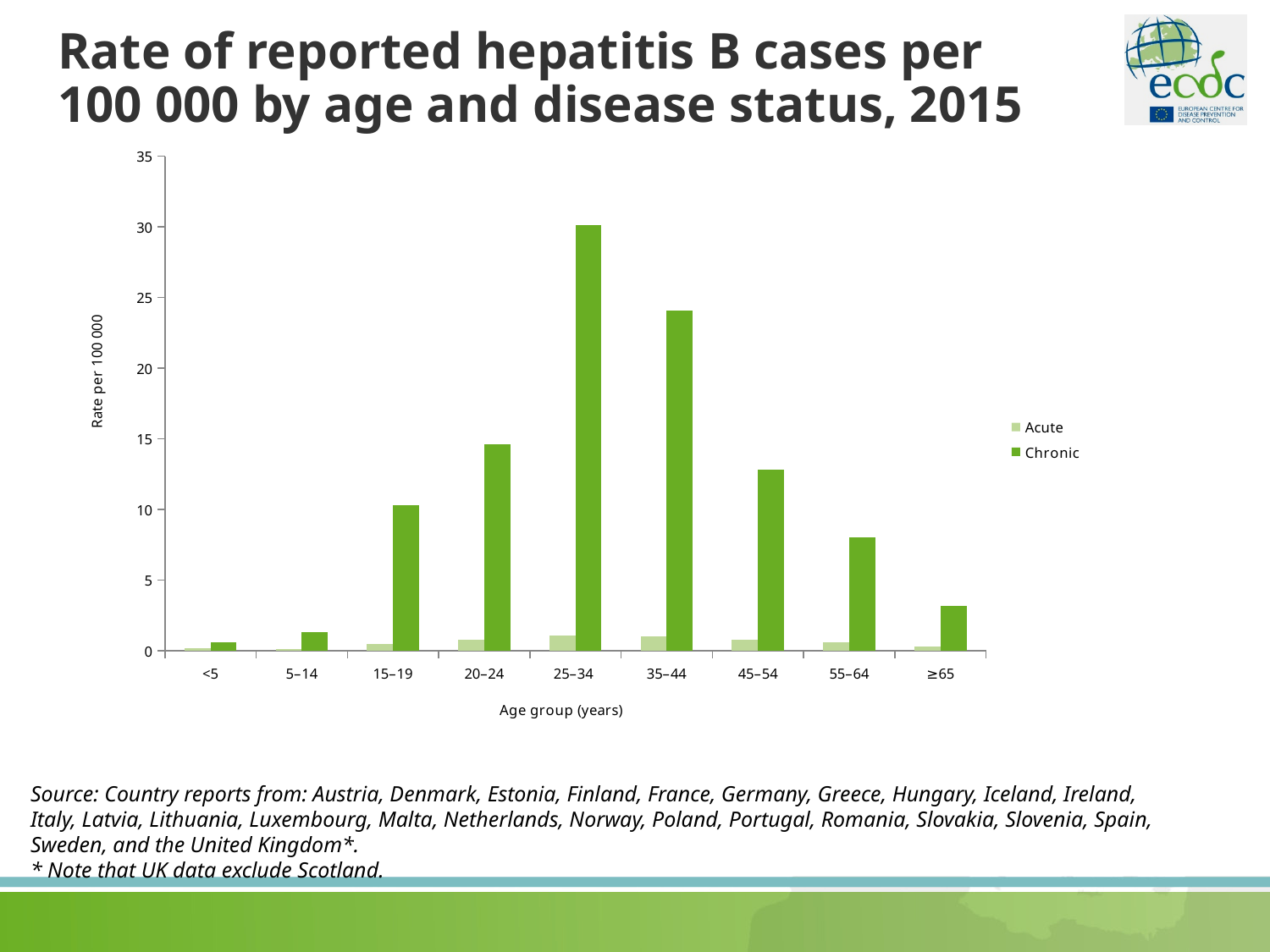
How many age groups are shown on the x axis? 9 Which age group has the highest Chronic rate? 25–34 Do the Chronic values rise or fall from the 25–34 age group to the ≥65 age group? fall Which is larger, the Chronic value for 20–24 or the Chronic value for 45–54? 20–24 Is the Chronic value for the 35–44 age group greater or less than 25? less Is the Chronic value for the 55–64 age group greater or less than 10? less What kind of chart is shown on the slide? bar chart How many series does the legend list? 2 What is the label of the y axis? Rate per 100 000 Which age group has the lowest Chronic rate? <5